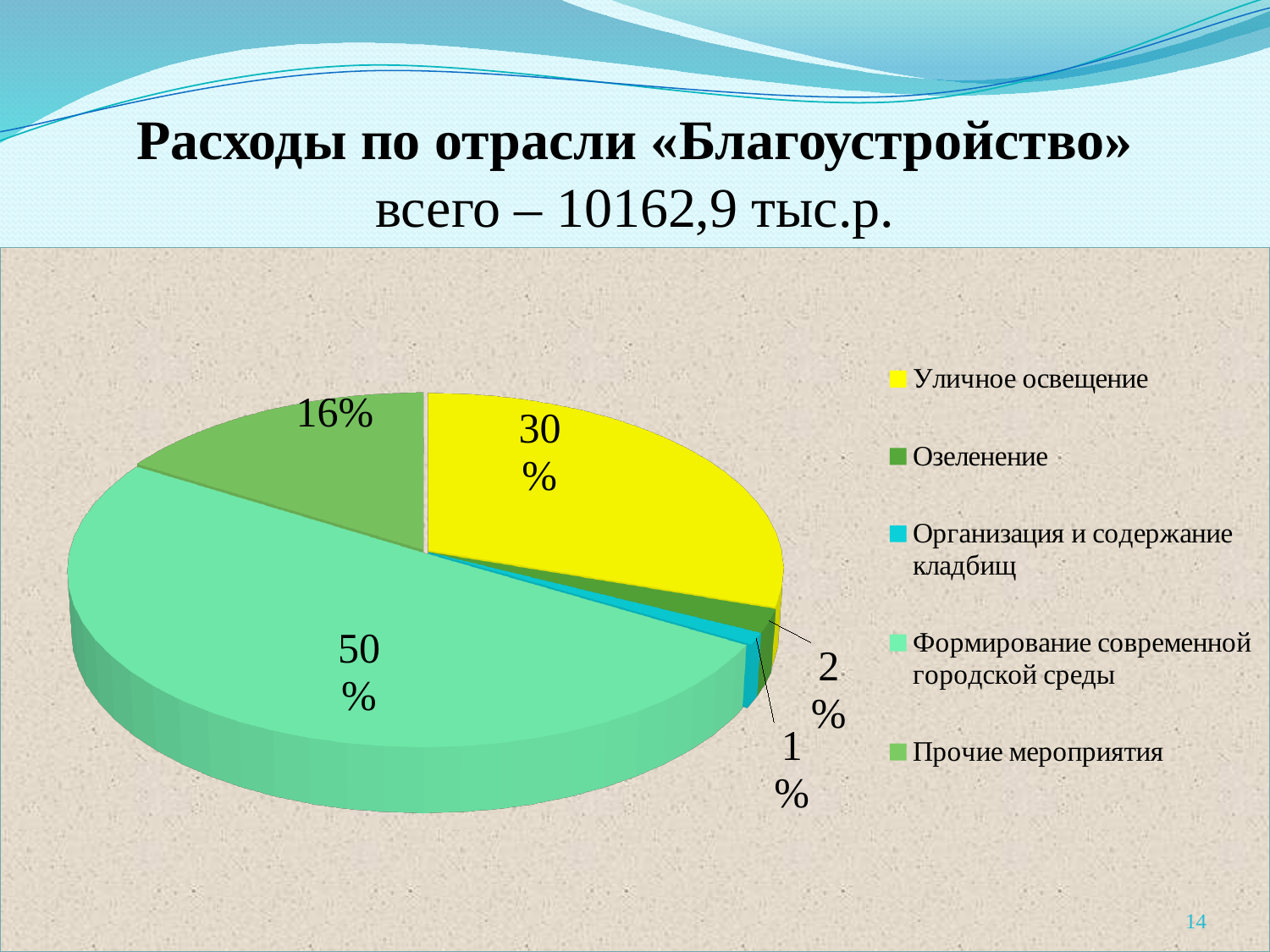
What share of the pie does «Прочие мероприятия» have? 16% Which category has the smallest share of the pie? Организация и содержание кладбищ Which category has the largest share of the pie? Формирование современной городской среды How many categories does the legend list? 5 What total amount is stated in the slide title? 10162,9 тыс.р. What share of the pie does «Формирование современной городской среды» have? 50% What share of the pie does «Организация и содержание кладбищ» have? 1% What is the difference in percentage points between «Формирование современной городской среды» and «Уличное освещение»? 20 Which is larger, the share for «Уличное освещение» or the share for «Прочие мероприятия»? Уличное освещение What share of the pie does «Уличное освещение» have? 30% What share of the pie does «Озеленение» have? 2% What kind of chart is shown on the slide? pie chart